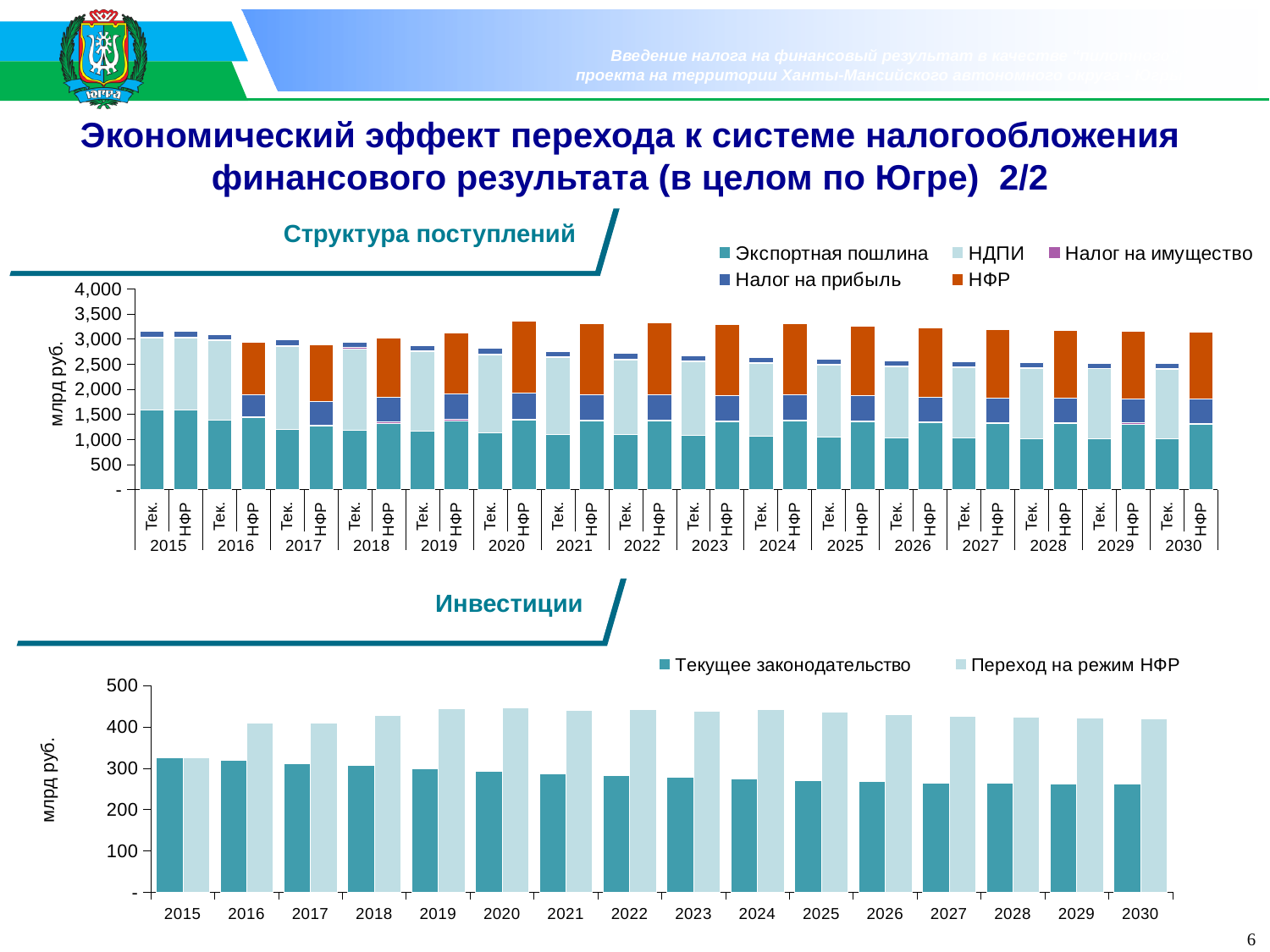
In the "Структура поступлений" chart, which bar is taller in 2020: Тек. or НФР? НФР In the "Инвестиции" chart, is the value for Текущее законодательство in 2030 greater or less than 300? less In the "Инвестиции" chart, is the value for Текущее законодательство in 2015 greater or less than 300? greater What kind of chart is the "Структура поступлений" chart? Stacked bar chart In the "Инвестиции" chart, do the values for Текущее законодательство rise or fall from 2015 to 2030? Fall How many series does the legend of the "Структура поступлений" chart list? 5 What unit is shown on the y axis of the "Структура поступлений" chart? млрд руб. How many years are shown on the x axis of the "Инвестиции" chart? 16 In the "Инвестиции" chart, which is larger in 2020: Текущее законодательство or Переход на режим НФР? Переход на режим НФР In the "Инвестиции" chart, is the value for Переход на режим НФР in 2020 greater or less than 400? greater What kind of chart is the "Инвестиции" chart? Bar chart How many series does the legend of the "Инвестиции" chart list? 2